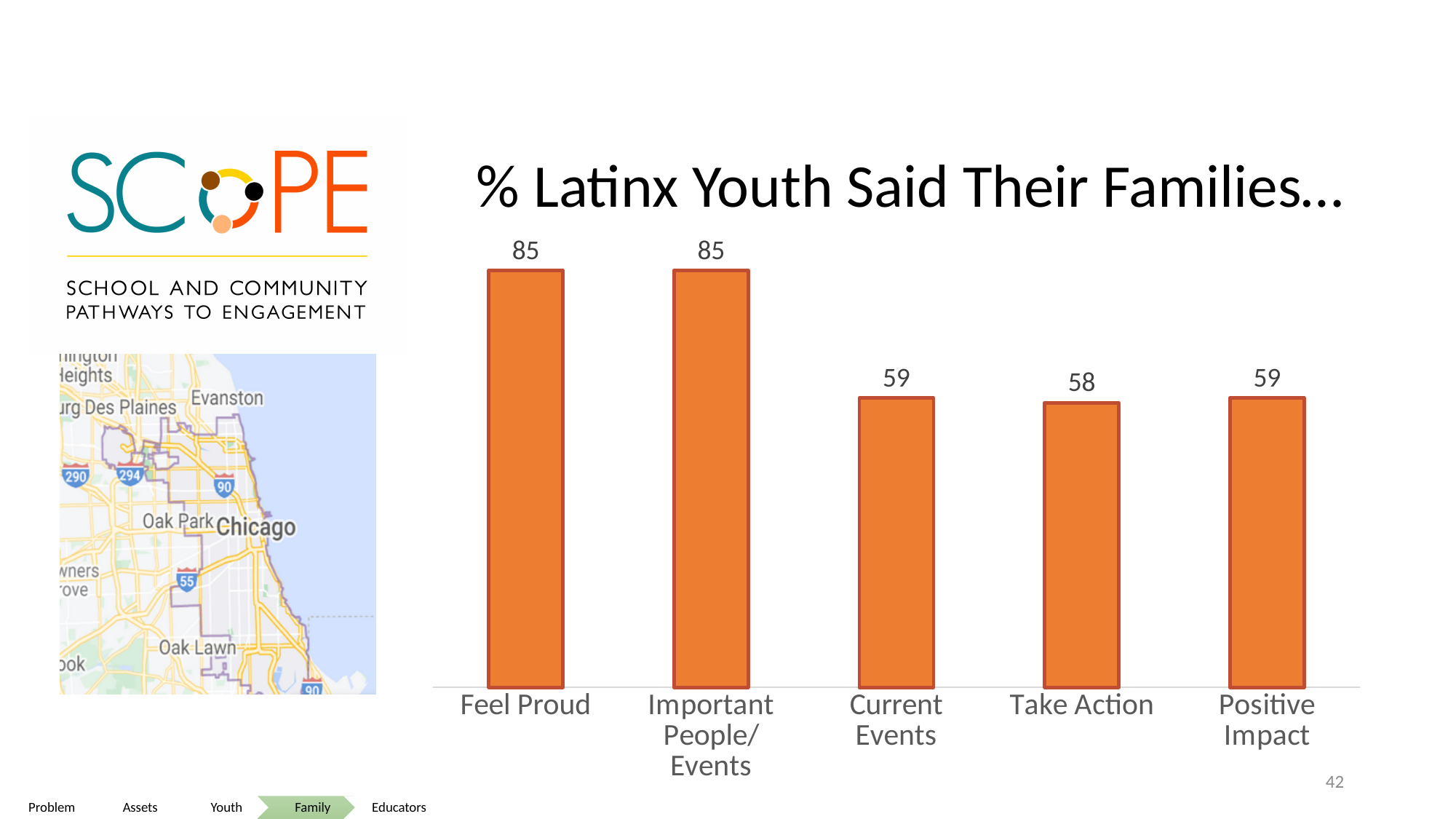
How many categories are shown in the chart? 5 What value is shown for Positive Impact? 59 Which category has the lowest value? Take Action Which is larger, the value for Feel Proud or the value for Positive Impact? Feel Proud What is the difference between the values for Feel Proud and Current Events? 26 What value is shown for Take Action? 58 What is the title of the chart? % Latinx Youth Said Their Families… What is the difference between the values for Important People/Events and Take Action? 27 What value is shown for Important People/Events? 85 What value is shown for Feel Proud? 85 What value is shown for Current Events? 59 What kind of chart is shown on the slide? Bar chart